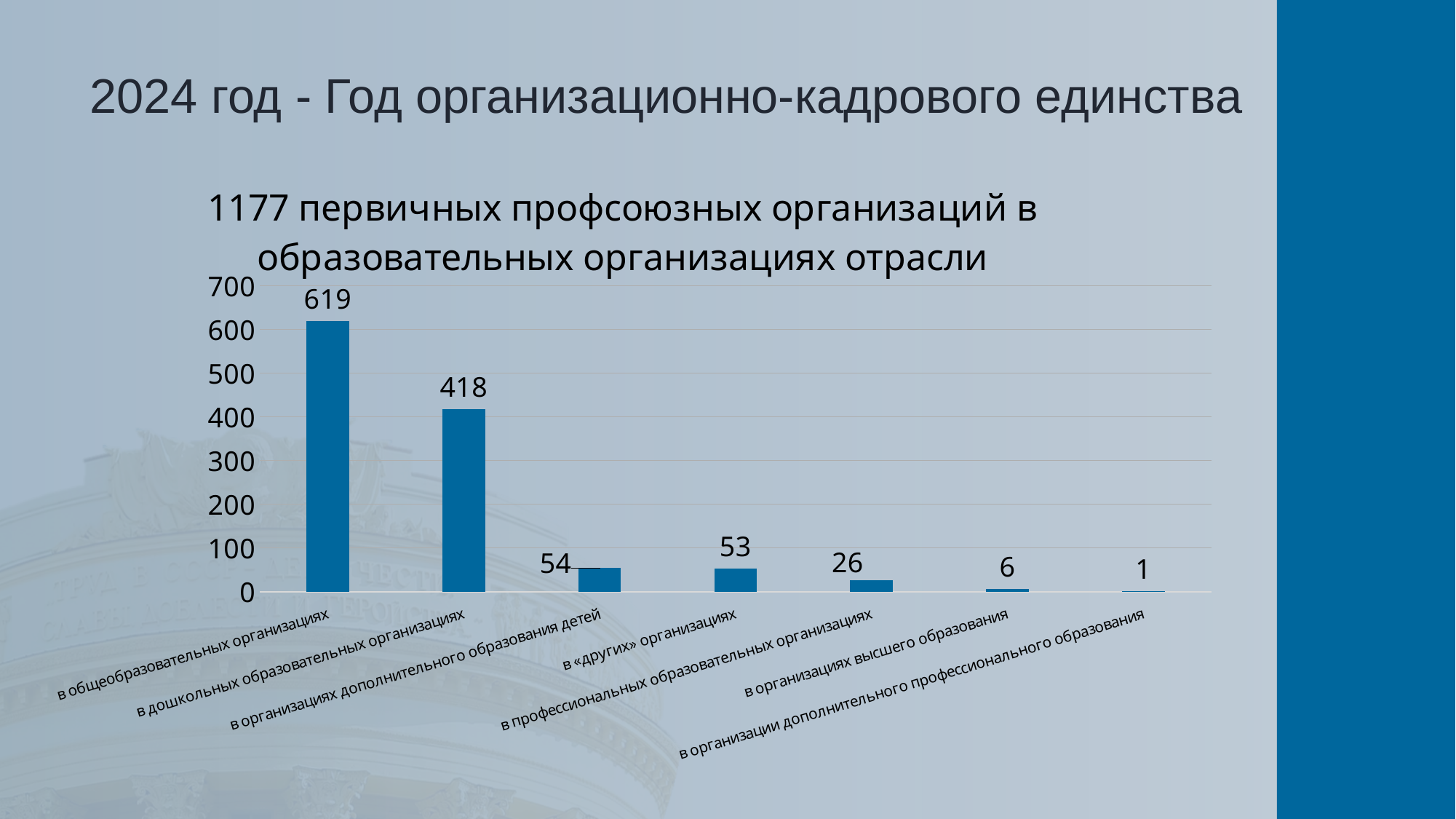
What kind of chart is shown on the slide? bar chart What is the value for «в организациях дополнительного образования детей»? 54 What is the title of the chart? 1177 первичных профсоюзных организаций в образовательных организациях отрасли Which is larger: the value for «в профессиональных образовательных организациях» or the value for «в организациях высшего образования»? в профессиональных образовательных организациях What is the difference between the values for «в общеобразовательных организациях» and «в дошкольных образовательных организациях»? 201 Which category has the highest value? в общеобразовательных организациях What is the value for «в дошкольных образовательных организациях»? 418 What is the value for «в организациях высшего образования»? 6 What is the value for «в общеобразовательных организациях»? 619 How many categories are shown in the chart? 7 What is the value for «в «других» организациях»? 53 Which category has the lowest value? в организации дополнительного профессионального образования